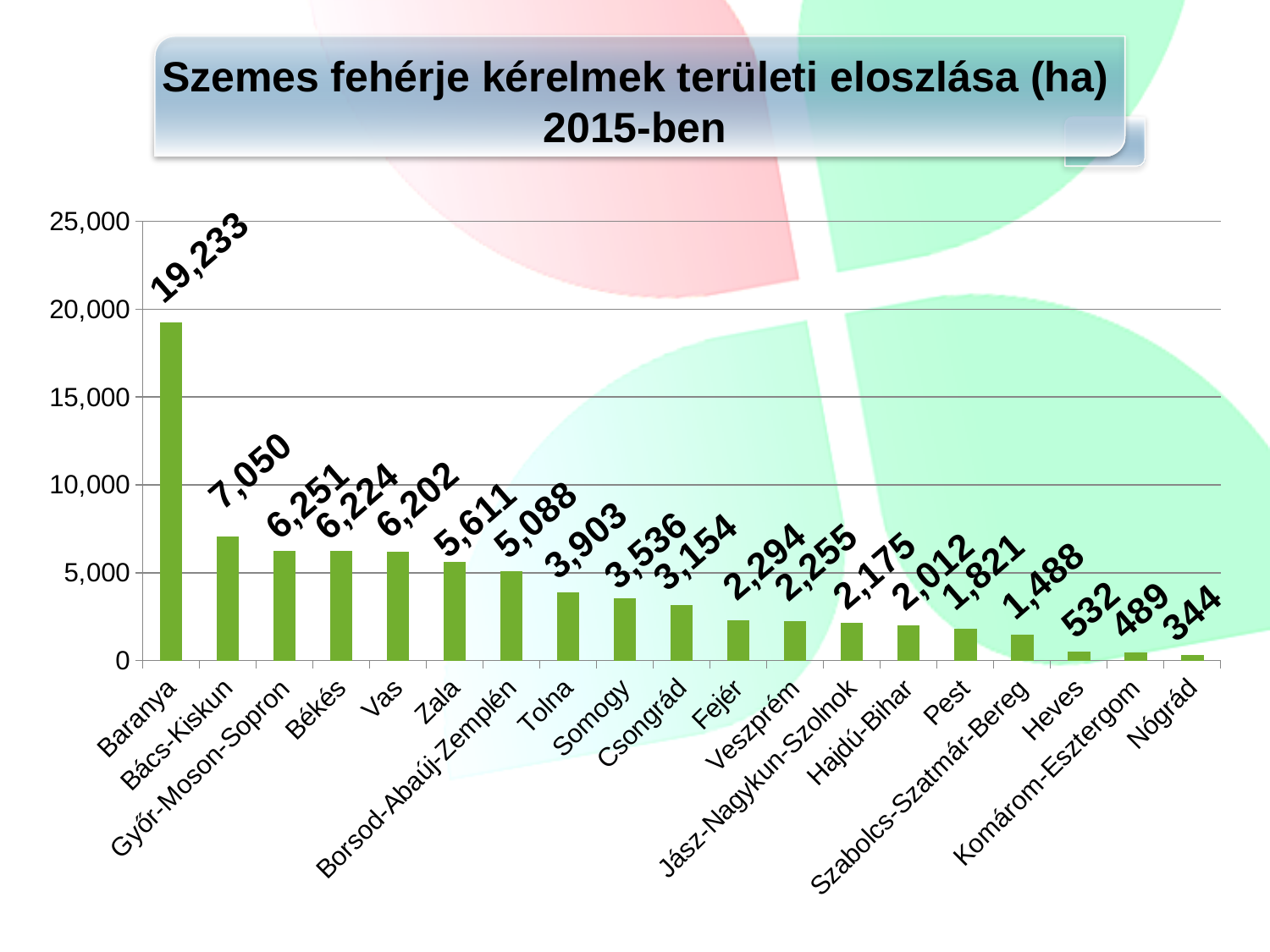
How many counties are shown on the x axis? 19 Is the value for Zala greater or less than 5,000? greater What kind of chart is shown on the slide? Bar chart Which county has the highest value? Baranya What is the value for Jász-Nagykun-Szolnok? 2,175 Which county has the lowest value? Nógrád What is the difference between the values for Baranya and Bács-Kiskun? 12,183 What is the value for Baranya? 19,233 What is the value for Borsod-Abaúj-Zemplén? 5,088 Do the values rise or fall from left to right along the x axis? Fall What is the difference between the values for Heves and Komárom-Esztergom? 43 Which is larger, the value for Tolna or the value for Somogy? Tolna